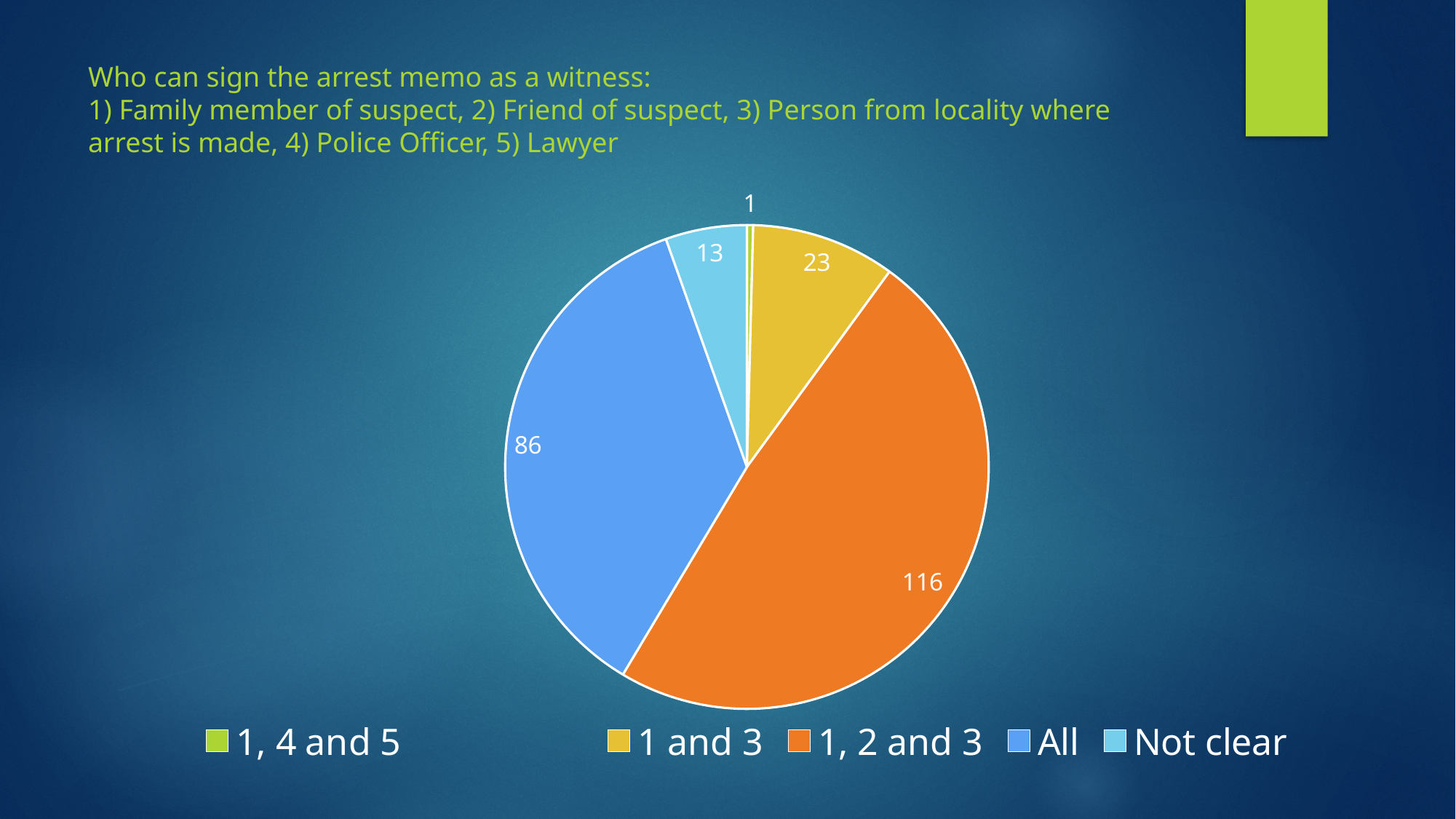
What is the difference between the values for "1, 2 and 3" and "All"? 30 What is the value for the "1 and 3" slice? 23 How many slices does the pie chart have? 5 Which is larger, the value for "1 and 3" or the value for "Not clear"? 1 and 3 What is the total of all the slice values in the pie chart? 239 Which legend entry is shown in orange? 1, 2 and 3 Which category has the smallest slice? 1, 4 and 5 Which category has the largest slice? 1, 2 and 3 What is the value for the "1, 2 and 3" slice? 116 What is the value for the "Not clear" slice? 13 What is the value for the "All" slice? 86 What kind of chart is shown on the slide? pie chart